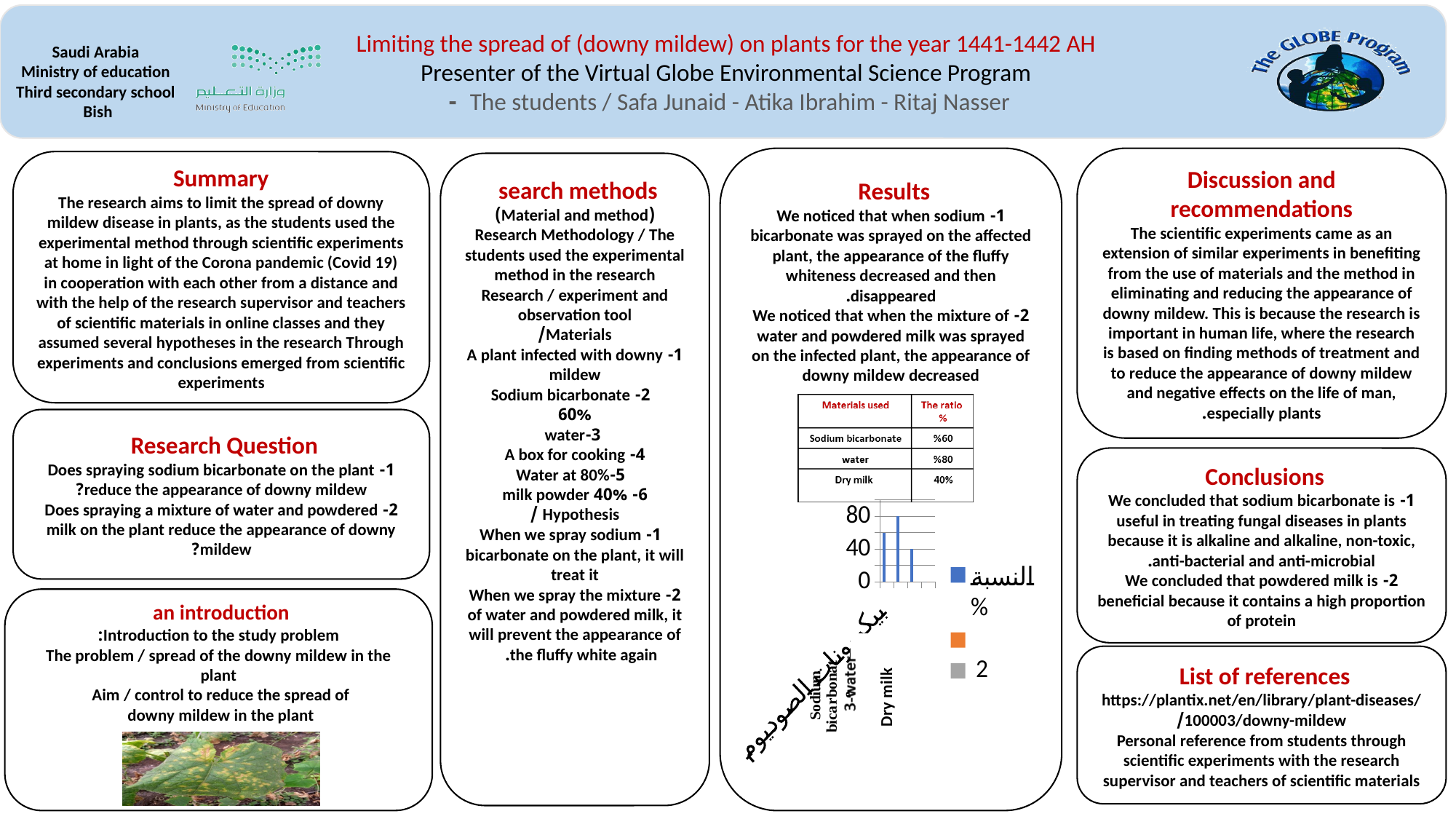
In the Results chart, which category has the highest bar? water In the Results chart, which is larger, the value for water or the value for Dry milk? water In the Results chart, what is the difference between the value for water and the value for Dry milk? 40 In the Results chart, which category has the lowest bar? Dry milk What kind of chart is shown in the Results section? bar chart What colour are the bars in the Results chart? blue How many bars does the chart in the Results section have? 3 How many entries does the legend of the Results chart list? 3 In the Results chart, what is the value for Dry milk? 40 In the Results chart, is the value for Sodium bicarbonate greater or less than 80? less In the Results chart, is the value for Sodium bicarbonate greater or less than 40? greater In the Results chart, what is the value for water? 80